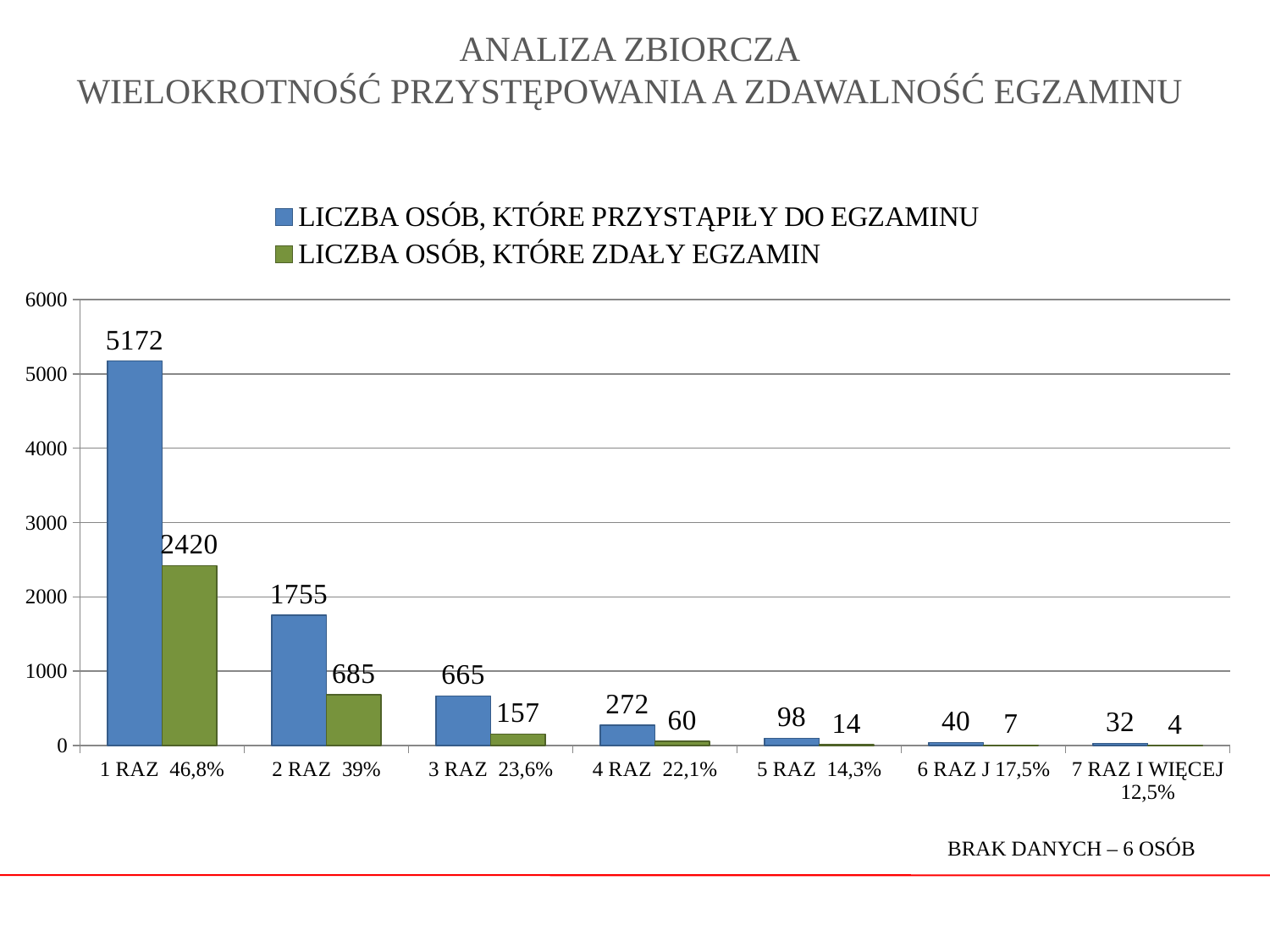
How many people took the exam for the first time (1 RAZ 46,8%) according to the series LICZBA OSÓB, KTÓRE PRZYSTĄPIŁY DO EGZAMINU? 5172 What is the difference between the number of people who took the exam and the number who passed it in the category 1 RAZ 46,8%? 2752 Which category has the highest value for LICZBA OSÓB, KTÓRE PRZYSTĄPIŁY DO EGZAMINU? 1 RAZ 46,8% What kind of chart is shown on the slide? Bar chart Which is larger: LICZBA OSÓB, KTÓRE ZDAŁY EGZAMIN for 2 RAZ 39% or LICZBA OSÓB, KTÓRE PRZYSTĄPIŁY DO EGZAMINU for 3 RAZ 23,6%? LICZBA OSÓB, KTÓRE ZDAŁY EGZAMIN for 2 RAZ 39% What is the value of LICZBA OSÓB, KTÓRE PRZYSTĄPIŁY DO EGZAMINU for the category 4 RAZ 22,1%? 272 Which category has the lowest value for LICZBA OSÓB, KTÓRE ZDAŁY EGZAMIN? 7 RAZ I WIĘCEJ 12,5% What is the value of LICZBA OSÓB, KTÓRE ZDAŁY EGZAMIN for the category 2 RAZ 39%? 685 How many categories are shown on the x axis of the chart? 7 What is the difference between LICZBA OSÓB, KTÓRE PRZYSTĄPIŁY DO EGZAMINU for 3 RAZ 23,6% and for 5 RAZ 14,3%? 567 What is the value of LICZBA OSÓB, KTÓRE ZDAŁY EGZAMIN for the category 7 RAZ I WIĘCEJ 12,5%? 4 How many series does the legend list? 2